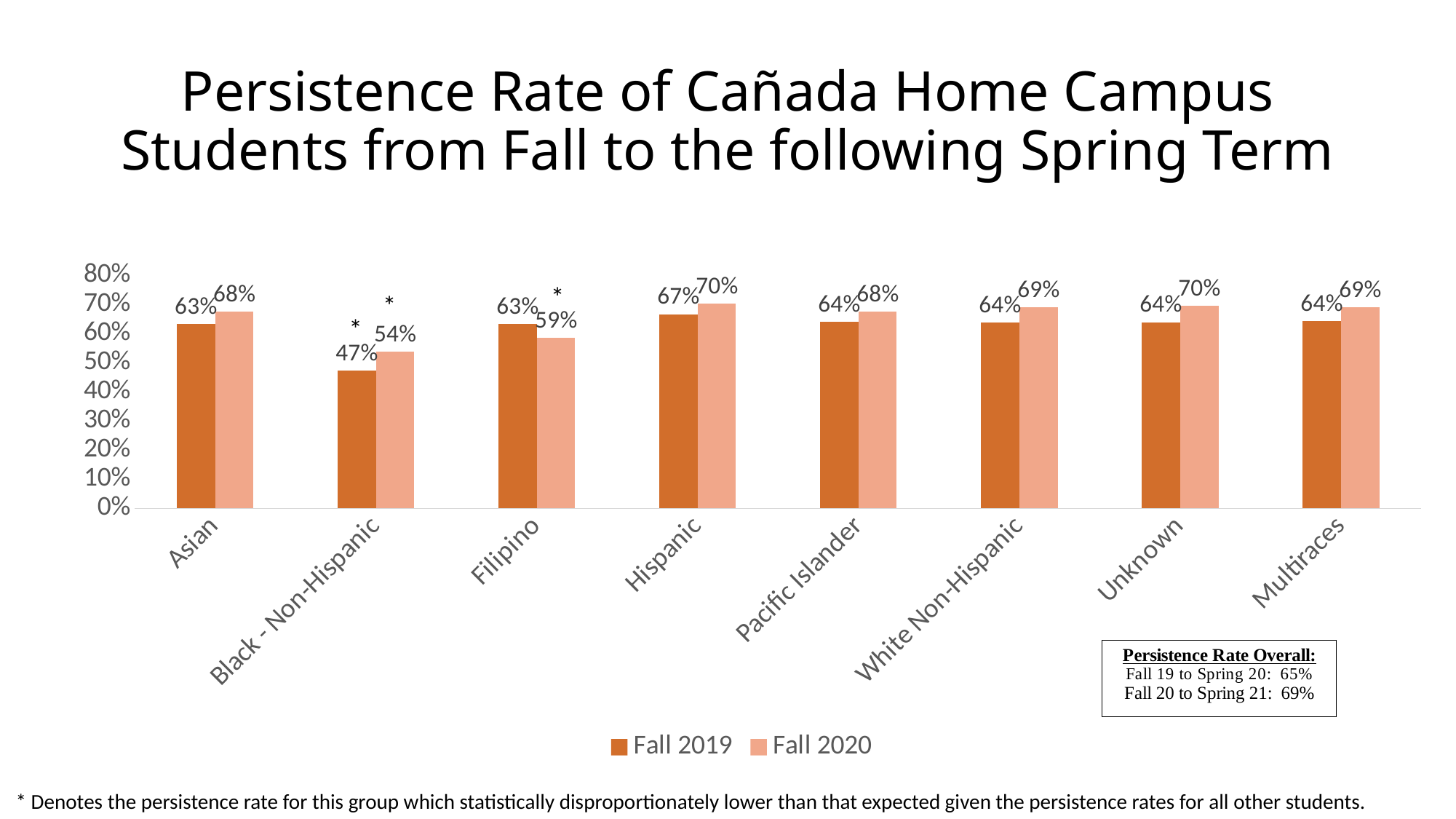
What is the difference between the Fall 2019 and Fall 2020 persistence rates for Asian students? 5% What is the Fall 2019 persistence rate for Black - Non-Hispanic students? 47% Which category has the lowest Fall 2019 persistence rate? Black - Non-Hispanic What is the difference between the Fall 2020 and Fall 2019 persistence rates for Black - Non-Hispanic students? 7% How many series does the legend list? 2 Which category has the highest Fall 2019 persistence rate? Hispanic What is the Fall 2020 persistence rate for Filipino students? 59% Is the Fall 2020 persistence rate for Filipino students higher or lower than the Fall 2020 rate for Pacific Islander students? lower What are the two series listed in the legend? Fall 2019 and Fall 2020 What kind of chart is shown on the slide? bar chart How many categories are shown on the x axis? 8 What is the Fall 2020 persistence rate for Hispanic students? 70%